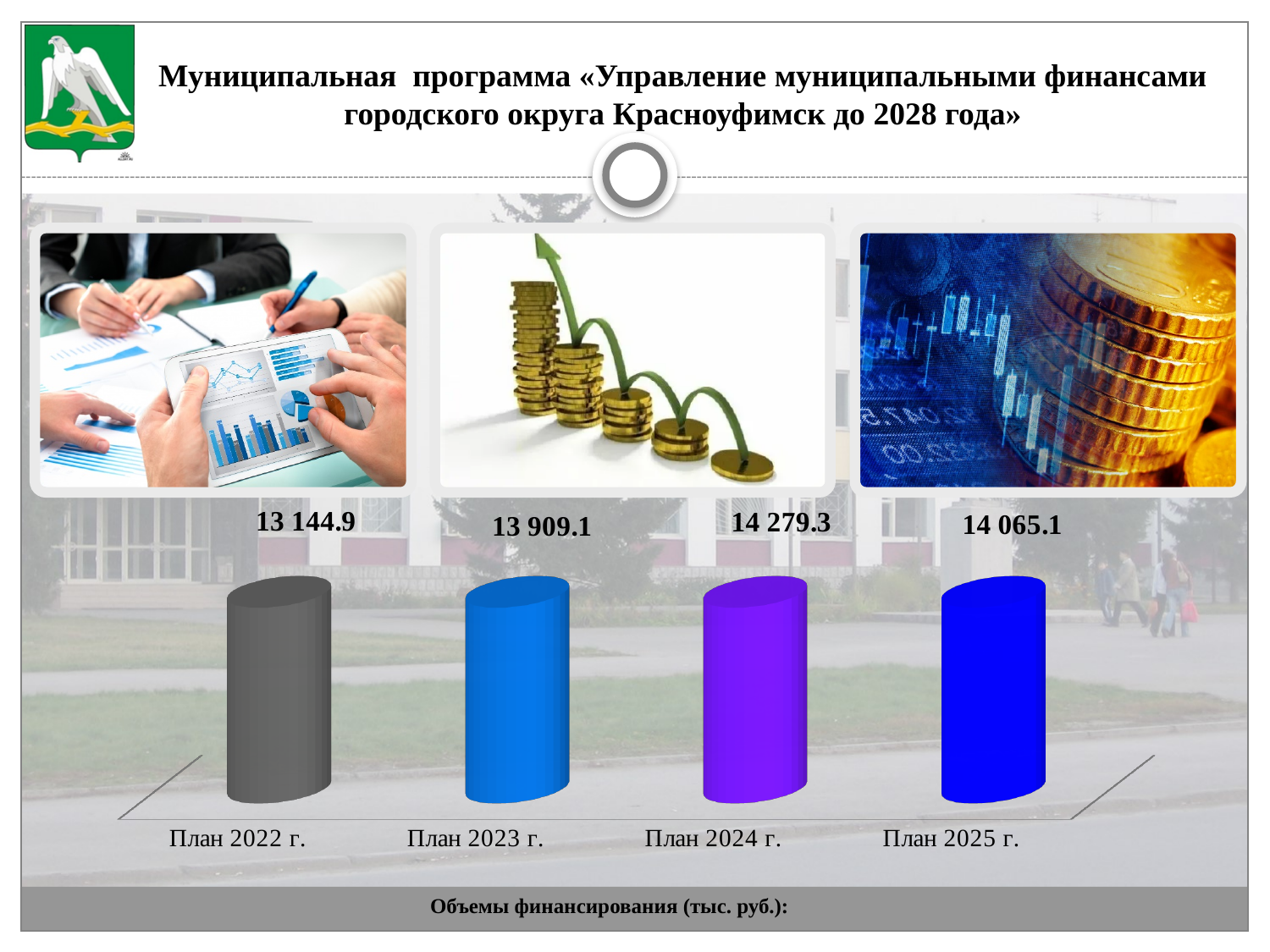
How many categories are shown in the chart? 4 What is the difference between the values for План 2023 г. and План 2022 г.? 764.2 Which category has the highest value? План 2024 г. What is the value for План 2022 г.? 13 144.9 What kind of chart is shown on the slide? Bar chart What is the value for План 2024 г.? 14 279.3 Which is larger, the value for План 2024 г. or the value for План 2025 г.? План 2024 г. What is the value for План 2023 г.? 13 909.1 Which category has the lowest value? План 2022 г. Do the values rise or fall from План 2022 г. to План 2024 г.? Rise What is the value for План 2025 г.? 14 065.1 What is the difference between the values for План 2024 г. and План 2022 г.? 1 134.4